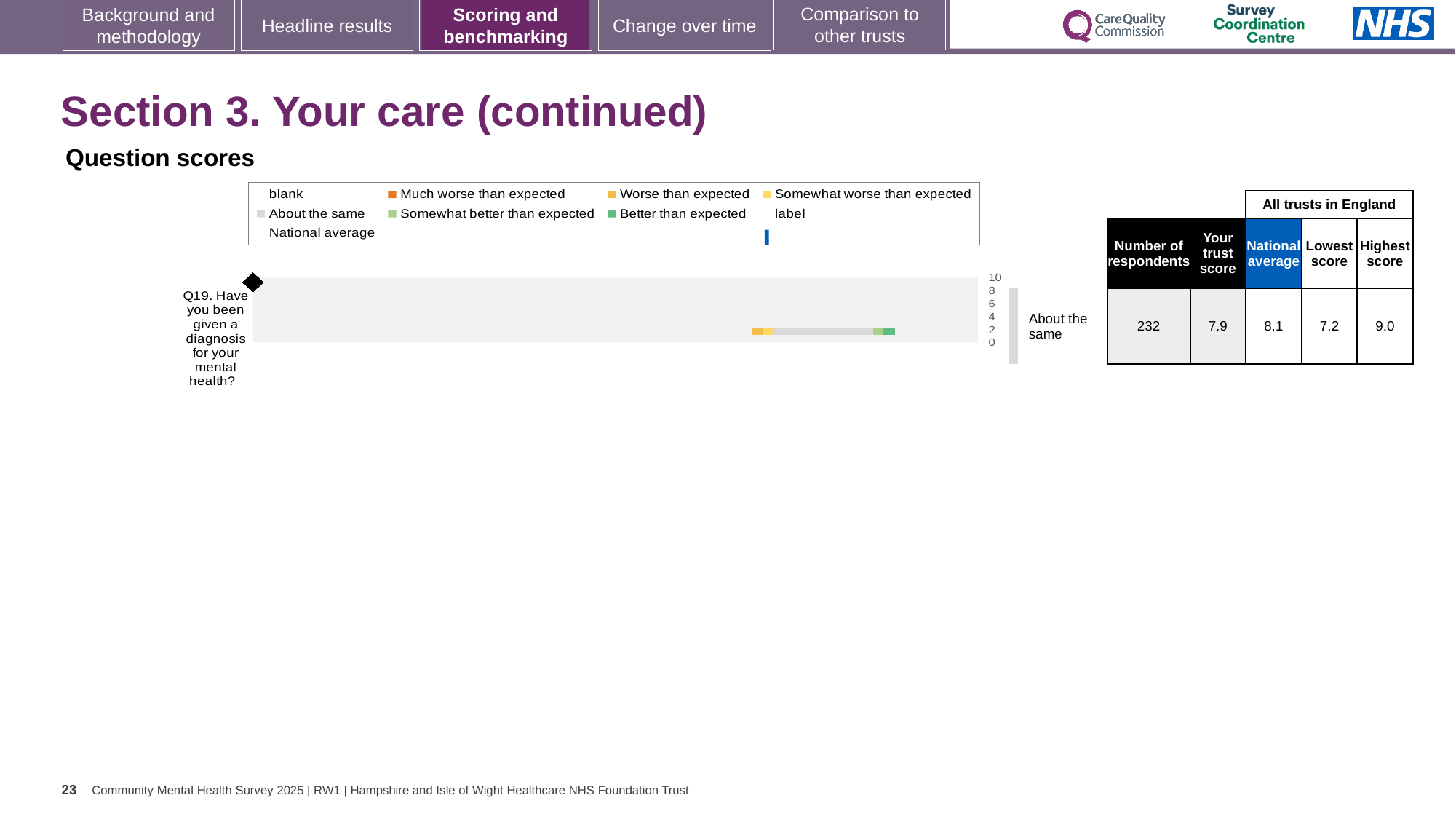
What is the lowest score among all trusts in England for Q19? 7.2 How many questions are plotted in the Question scores chart? 1 What is the number of respondents for Q19? 232 For Q19, which is larger: the trust score or the national average? national average For Q19, what is the difference between the national average and the trust score? 0.2 What is the trust score for Q19? 7.9 Which question is plotted in the Question scores chart? Q19. Have you been given a diagnosis for your mental health? What is the national average score for Q19? 8.1 What is the highest score among all trusts in England for Q19? 9.0 For Q19, what is the difference between the highest and lowest scores among all trusts in England? 1.8 What kind of chart is used to show the Q19 question score? bar chart What benchmark category is shown next to the Q19 bar? About the same